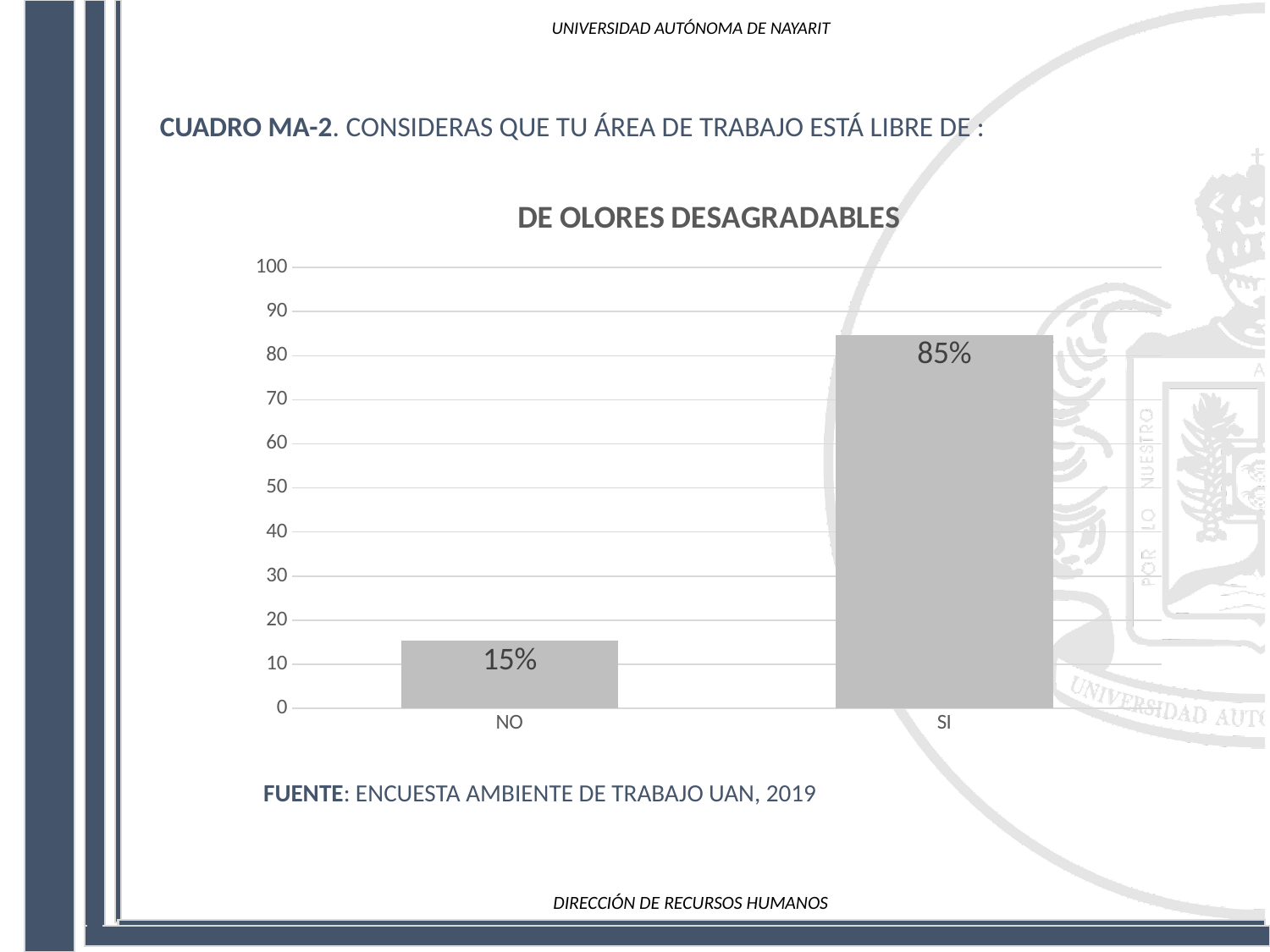
What is the value for NO? 15% How many categories are shown on the x axis? 2 What is the difference between the values for SI and NO? 70% Which is larger, the value for NO or the value for SI? SI Which category has the highest value? SI Is the value for NO greater or less than 20? less Is the value for SI greater or less than 50? greater What kind of chart is shown? bar chart Which category has the lowest value? NO What is the maximum value shown on the y axis? 100 What is the value for SI? 85% What is the title of the chart? DE OLORES DESAGRADABLES